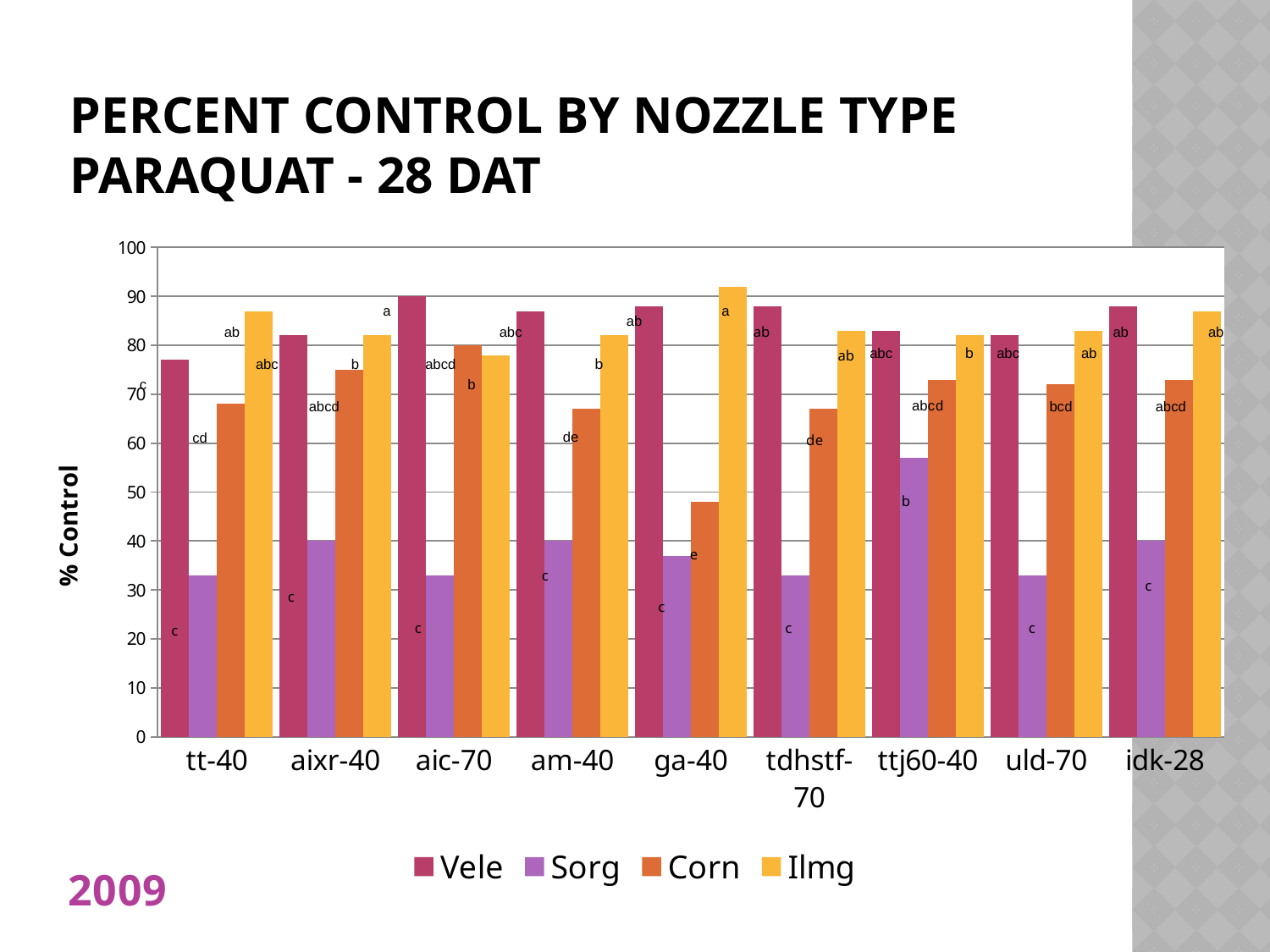
What is the label on the vertical axis? % Control Is the Sorg value for ttj60-40 greater or less than 50? greater Which series has the lowest value for ttj60-40? Sorg How many nozzle types (categories) are shown on the x axis? 9 Which series has the highest value for ga-40? Ilmg For which nozzle type is the Sorg value highest? ttj60-40 Is the Corn value for ga-40 greater or less than 60? less Is the Vele value for aic-70 greater or less than 80? greater For am-40, which is larger, the Ilmg value or the Corn value? Ilmg What kind of chart is shown on the slide? bar chart How many series does the legend list? 4